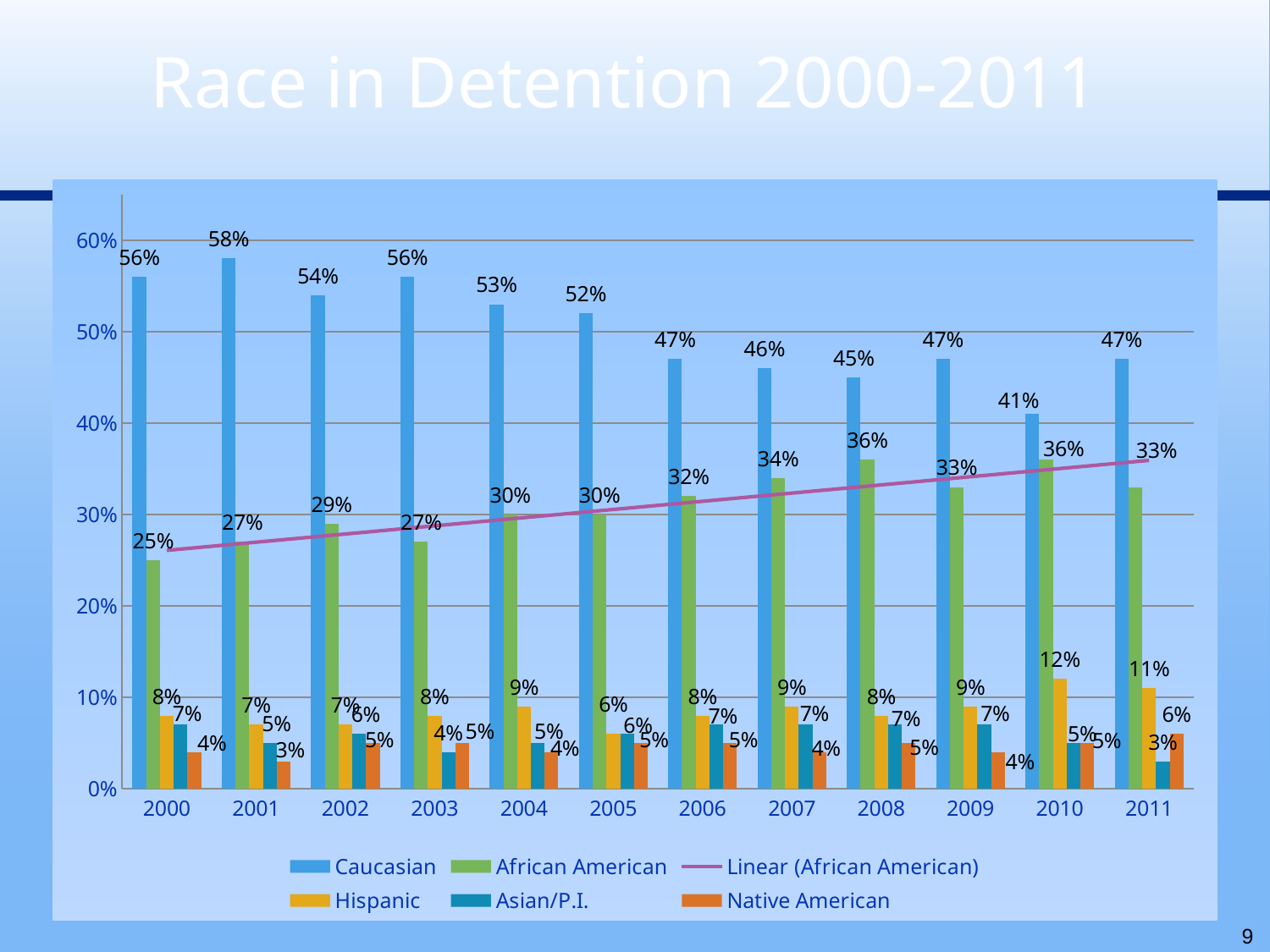
What is the Caucasian value for 2001? 58% What is the Hispanic value for 2010? 12% What is the African American value for 2000? 25% In which year is the Caucasian value highest? 2001 What kind of chart is shown on the slide? Bar chart How many entries does the legend list? 6 Does the Caucasian value generally rise or fall from 2000 to 2011? Fall In which year is the Caucasian value lowest? 2010 Which is larger in 2008: the Hispanic value or the Asian/P.I. value? Hispanic What is the Caucasian value for 2010? 41% How many years are shown on the x axis? 12 What is the difference between the Caucasian and African American values in 2011? 14%